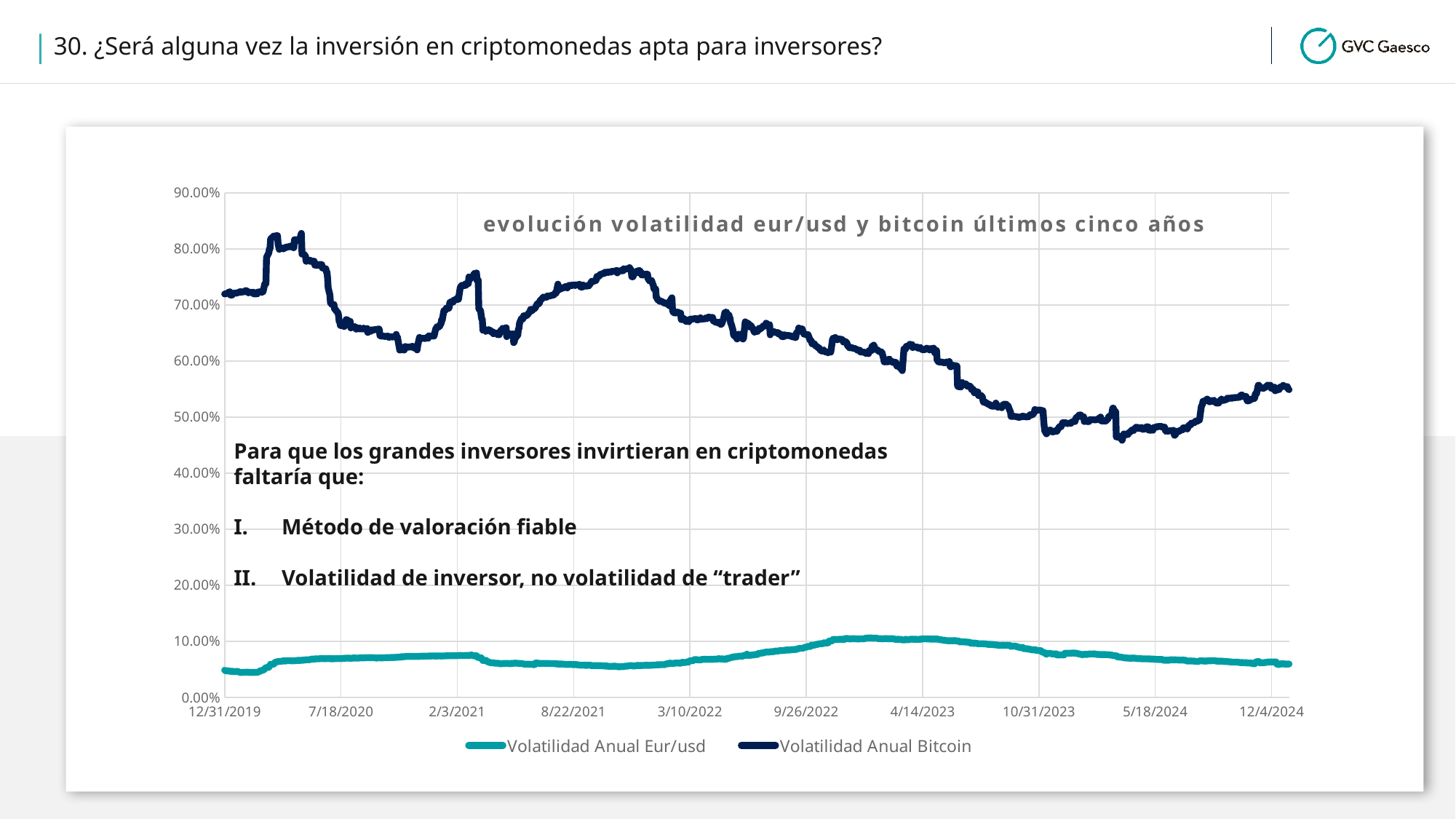
Is the value for Volatilidad Anual Bitcoin at 4/14/2023 greater or less than 70.00%? less What kind of chart is shown on the slide? line chart Is the value for Volatilidad Anual Eur/usd at 12/31/2019 greater or less than 10.00%? less Which series is drawn in the dark navy colour? Volatilidad Anual Bitcoin Does the Volatilidad Anual Bitcoin series overall rise or fall from 12/31/2019 to 12/4/2024? fall Is the value for Volatilidad Anual Bitcoin at 12/31/2019 greater or less than 70.00%? greater What is the title of the chart? evolución volatilidad eur/usd y bitcoin últimos cinco años Which series stays higher across the whole period shown? Volatilidad Anual Bitcoin Which series has the higher value at 9/26/2022, Volatilidad Anual Eur/usd or Volatilidad Anual Bitcoin? Volatilidad Anual Bitcoin How many series does the chart legend list? 2